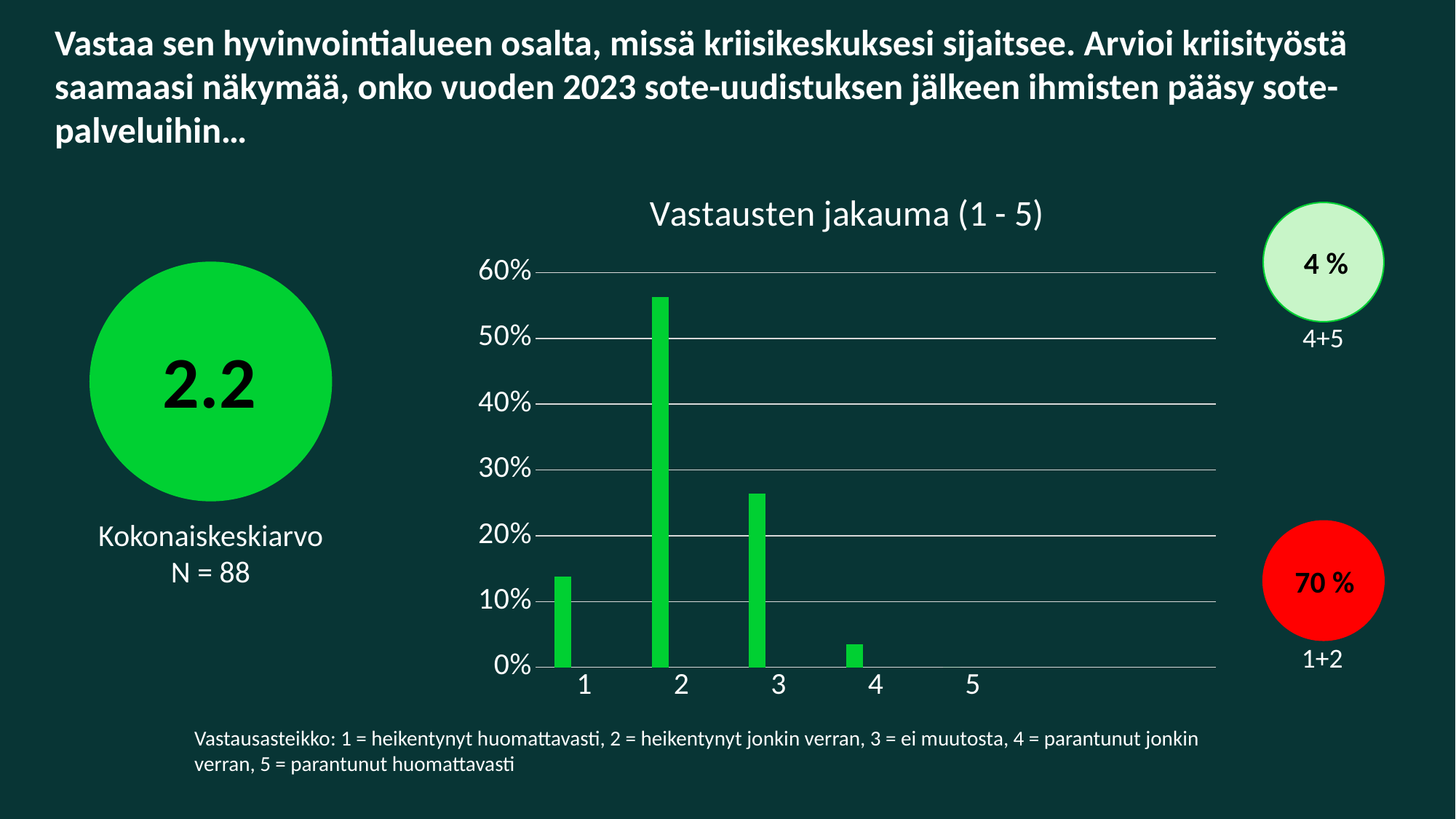
Is the value for category 4 greater or less than 10%? less Which has the larger value, category 2 or category 3? 2 Which category has the highest value in the chart? 2 Is the value for category 1 greater or less than 10%? greater Is the value for category 3 greater or less than 20%? greater What is the title of the chart? Vastausten jakauma (1 - 5) How many categories are shown on the x axis of the chart? 5 What kind of chart is shown on the slide? bar chart Which category has the lowest value in the chart? 5 Which has the larger value, category 1 or category 3? 3